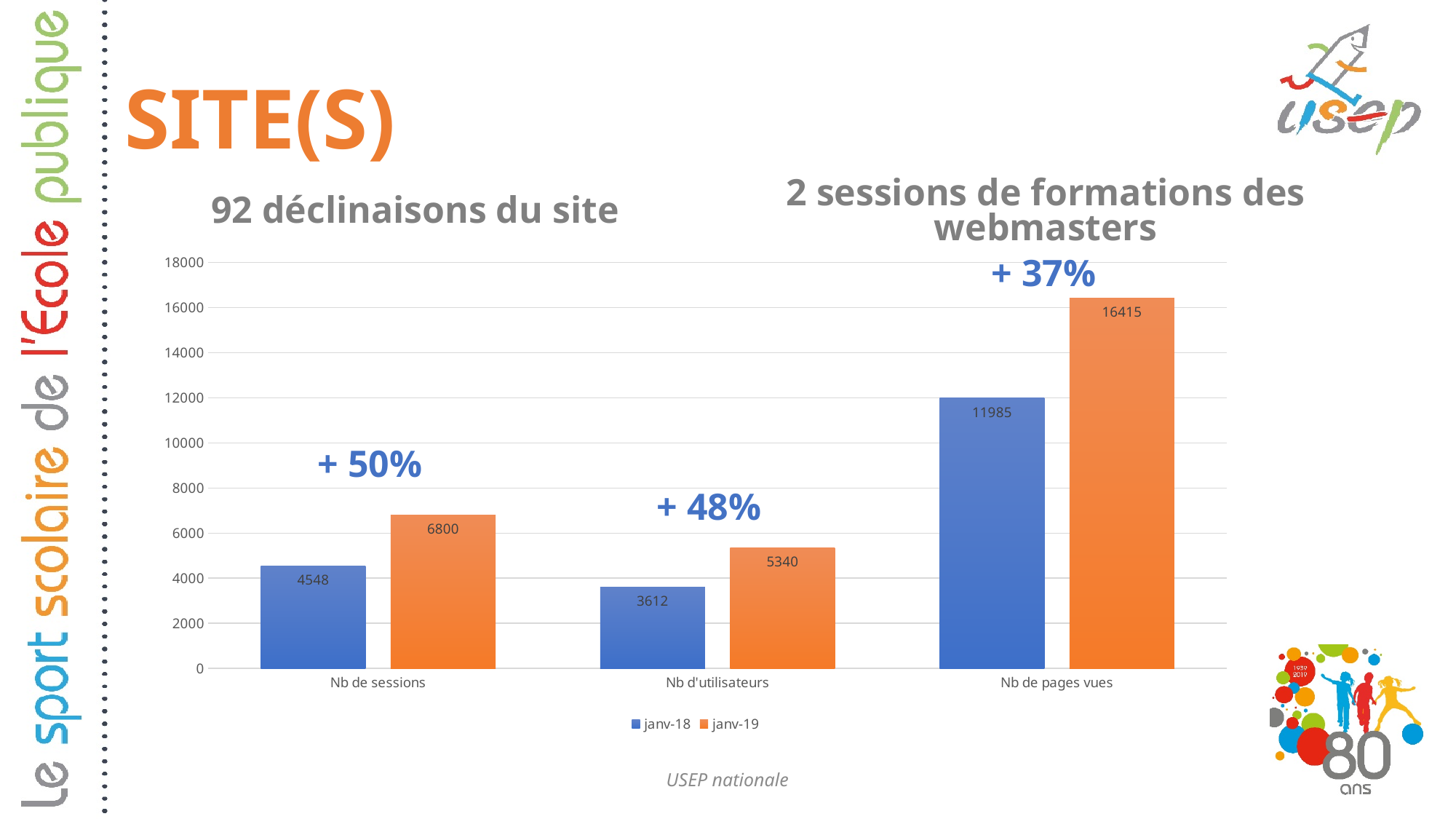
How many series does the legend list? 2 What is the janv-18 value for Nb de sessions? 4548 What is the difference between the janv-19 and janv-18 values for Nb de sessions? 2252 Which category has the lowest janv-18 value? Nb d'utilisateurs What is the janv-19 value for Nb d'utilisateurs? 5340 Which is larger: the janv-18 value for Nb de sessions or the janv-19 value for Nb d'utilisateurs? janv-19 value for Nb d'utilisateurs Which category has the highest janv-19 value? Nb de pages vues How many categories are shown on the x axis? 3 Is the janv-18 value for Nb de pages vues greater or less than 10000? greater What kind of chart is shown on the slide? bar chart What is the difference between the janv-19 and janv-18 values for Nb de pages vues? 4430 What is the janv-19 value for Nb de pages vues? 16415